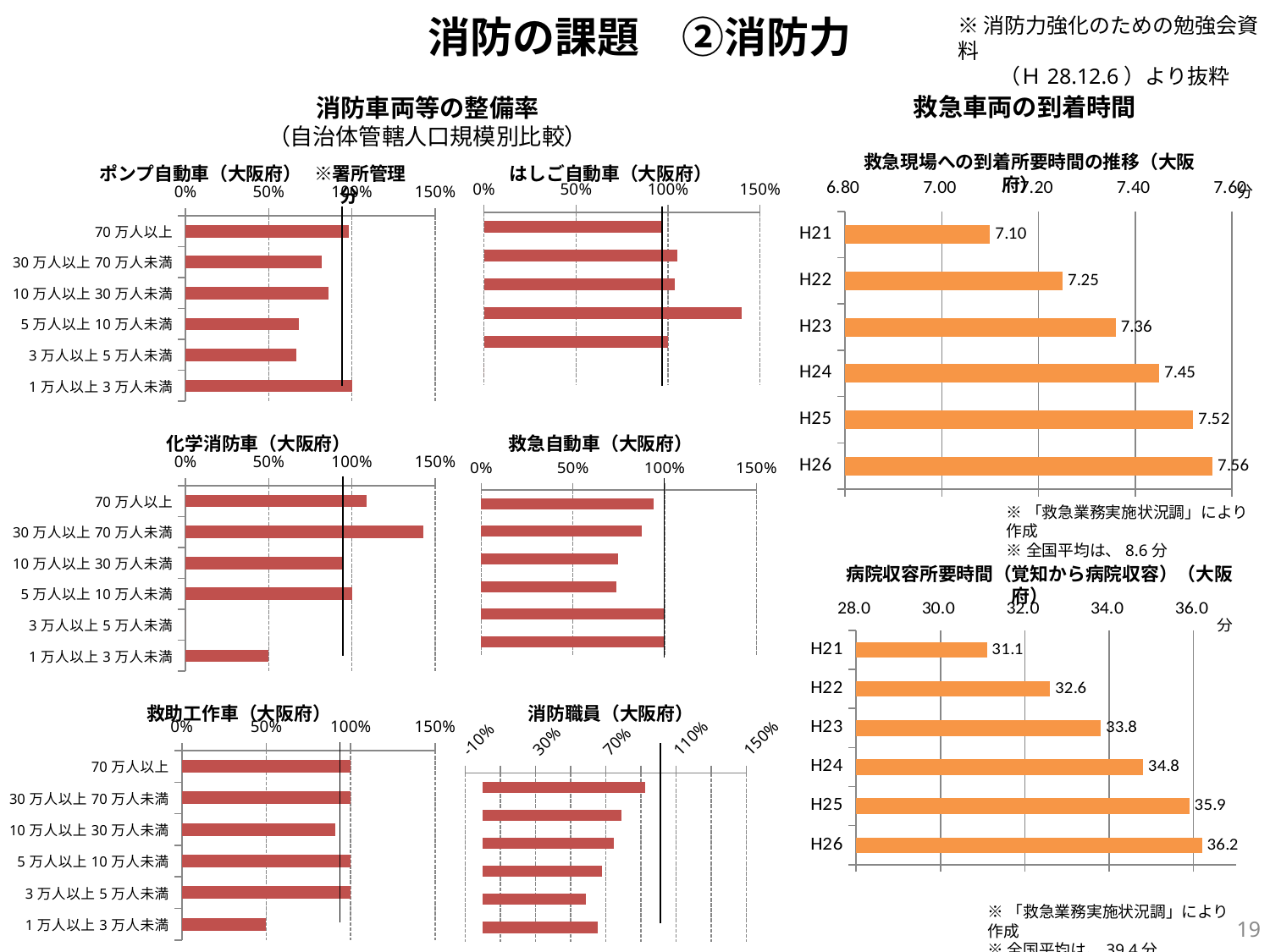
In the 病院収容所要時間（覚知から病院収容）（大阪府） chart, how many years are plotted? 6 In the 病院収容所要時間（覚知から病院収容）（大阪府） chart, which year has the highest value? H26 In the 化学消防車（大阪府） chart, which category has the highest value? 30万人以上70万人未満 What kind of chart is the 救急現場への到着所要時間の推移（大阪府） chart? bar chart In the 救急現場への到着所要時間の推移（大阪府） chart, what is the value for H26? 7.56 In the 救急現場への到着所要時間の推移（大阪府） chart, what is the difference between the H26 and H21 values? 0.46 In the 病院収容所要時間（覚知から病院収容）（大阪府） chart, what is the value for H23? 33.8 In the 病院収容所要時間（覚知から病院収容）（大阪府） chart, what is the difference between the H25 and H24 values? 1.1 In the 救助工作車（大阪府） chart, which category has the lowest value? 1万人以上3万人未満 In the 救急現場への到着所要時間の推移（大阪府） chart, do the values rise or fall from H21 to H26? rise In the ポンプ自動車（大阪府） chart, is the value for 5万人以上10万人未満 greater or less than 100%? less In the 救急現場への到着所要時間の推移（大阪府） chart, what is the value for H21? 7.10